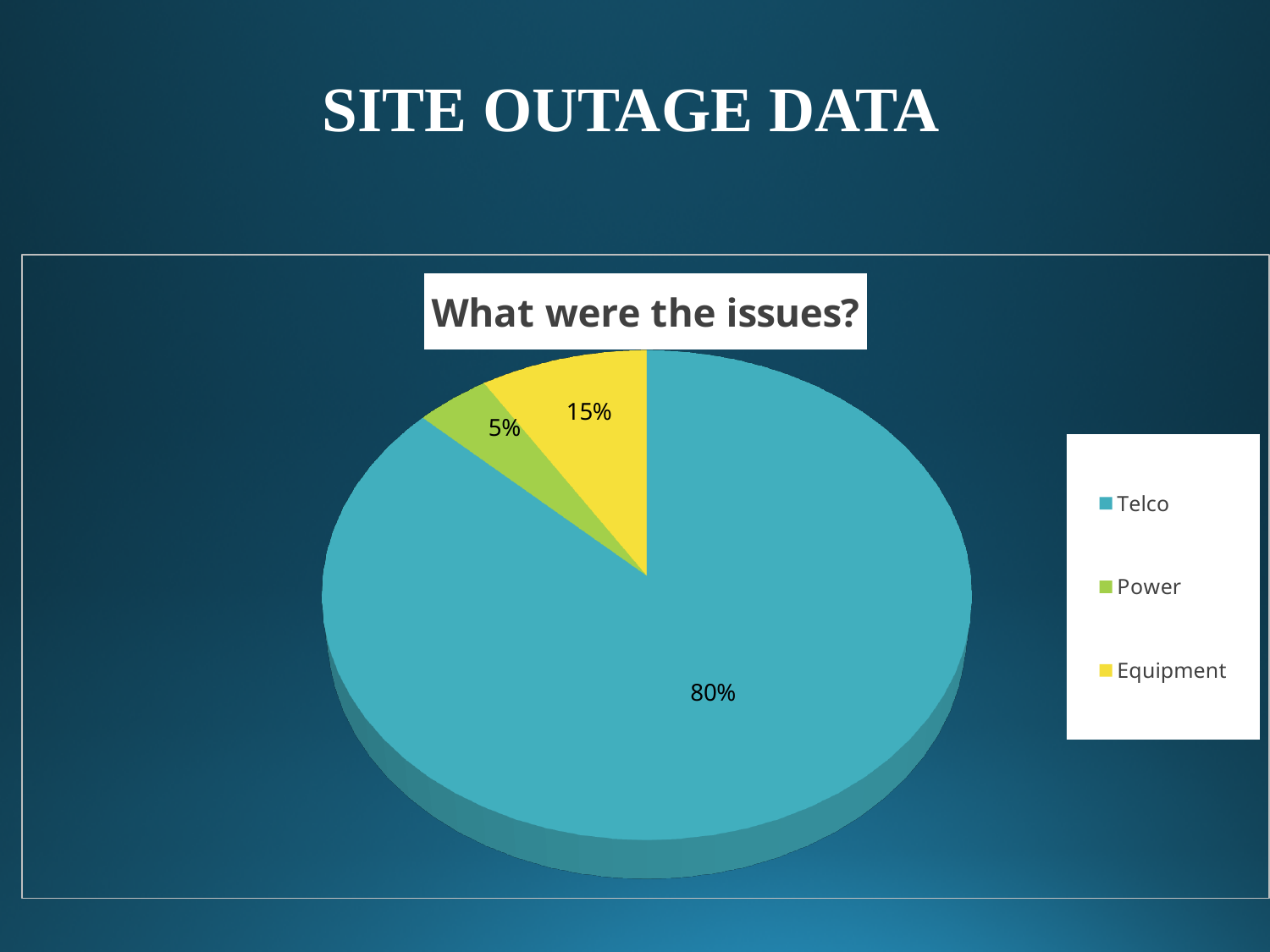
How many categories are shown in the pie chart? 3 What kind of chart is shown on the slide? Pie chart What is the title of the chart? What were the issues? What share of the pie does Telco account for? 80% What share of the pie does Power account for? 5% Which category has the smallest slice of the pie? Power Which category has the largest slice of the pie? Telco What share of the pie does Equipment account for? 15% Which is larger, the Equipment slice or the Power slice? Equipment Which colour represents Equipment in the legend? Yellow What is the difference in percentage points between the Equipment and Power slices? 10 What is the difference in percentage points between the Telco and Equipment slices? 65